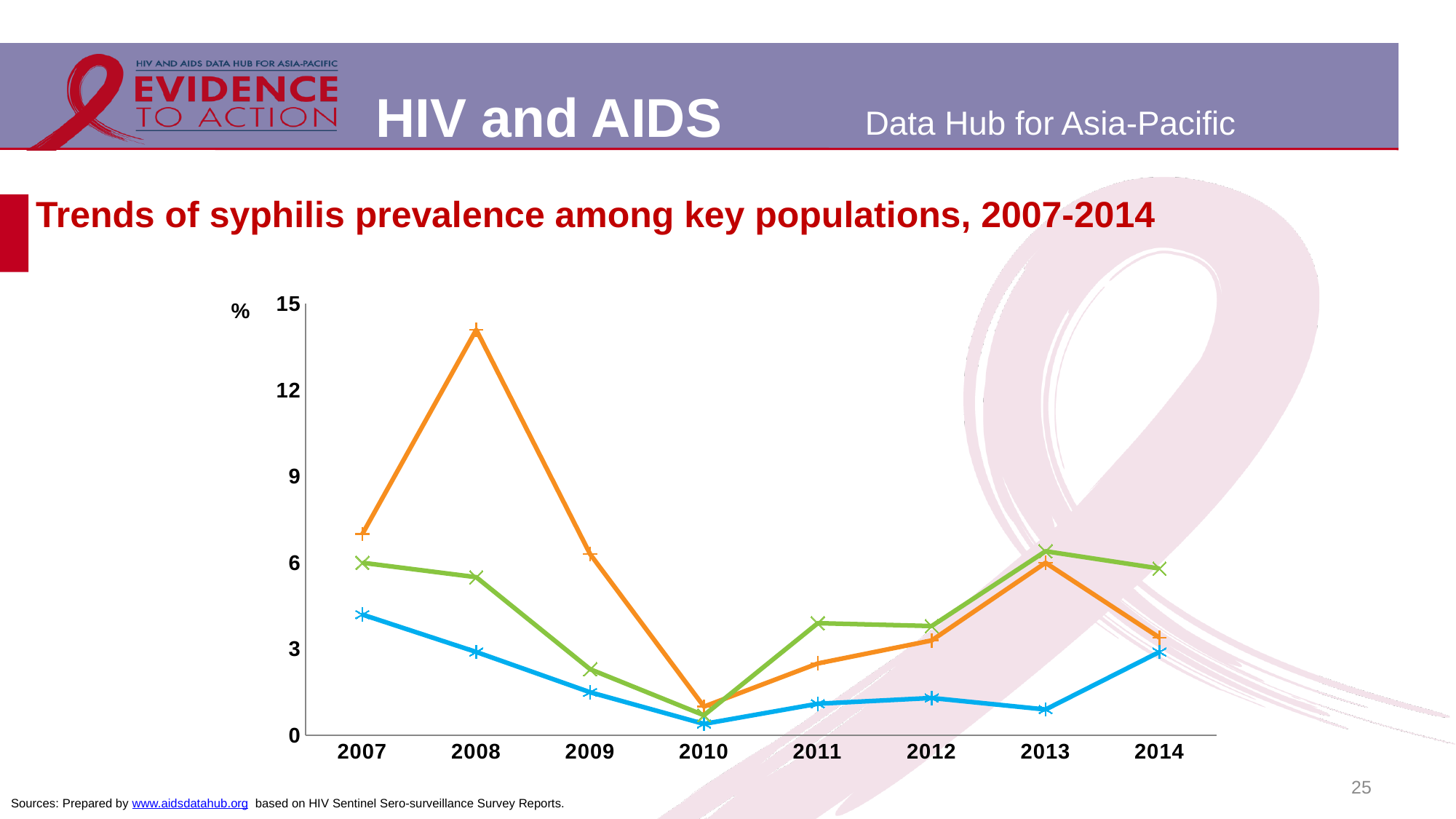
What is the title of the chart on the slide? Trends of syphilis prevalence among key populations, 2007-2014 Does the orange line rise or fall between 2008 and 2010? fall What unit is shown on the y axis of the chart? % Is the value of the orange line in 2008 greater or less than 12? greater How many years are shown along the x axis of the chart? 8 In which year does the orange line reach its highest value? 2008 How many lines are plotted on the chart? 3 What kind of chart is shown on the slide? line chart Is the value of the green line in 2010 greater or less than 3? less In which year does the blue line reach its lowest value? 2010 In 2011, which line has the higher value, the green line or the orange line? green line Is the value of the blue line in 2007 greater or less than 3? greater